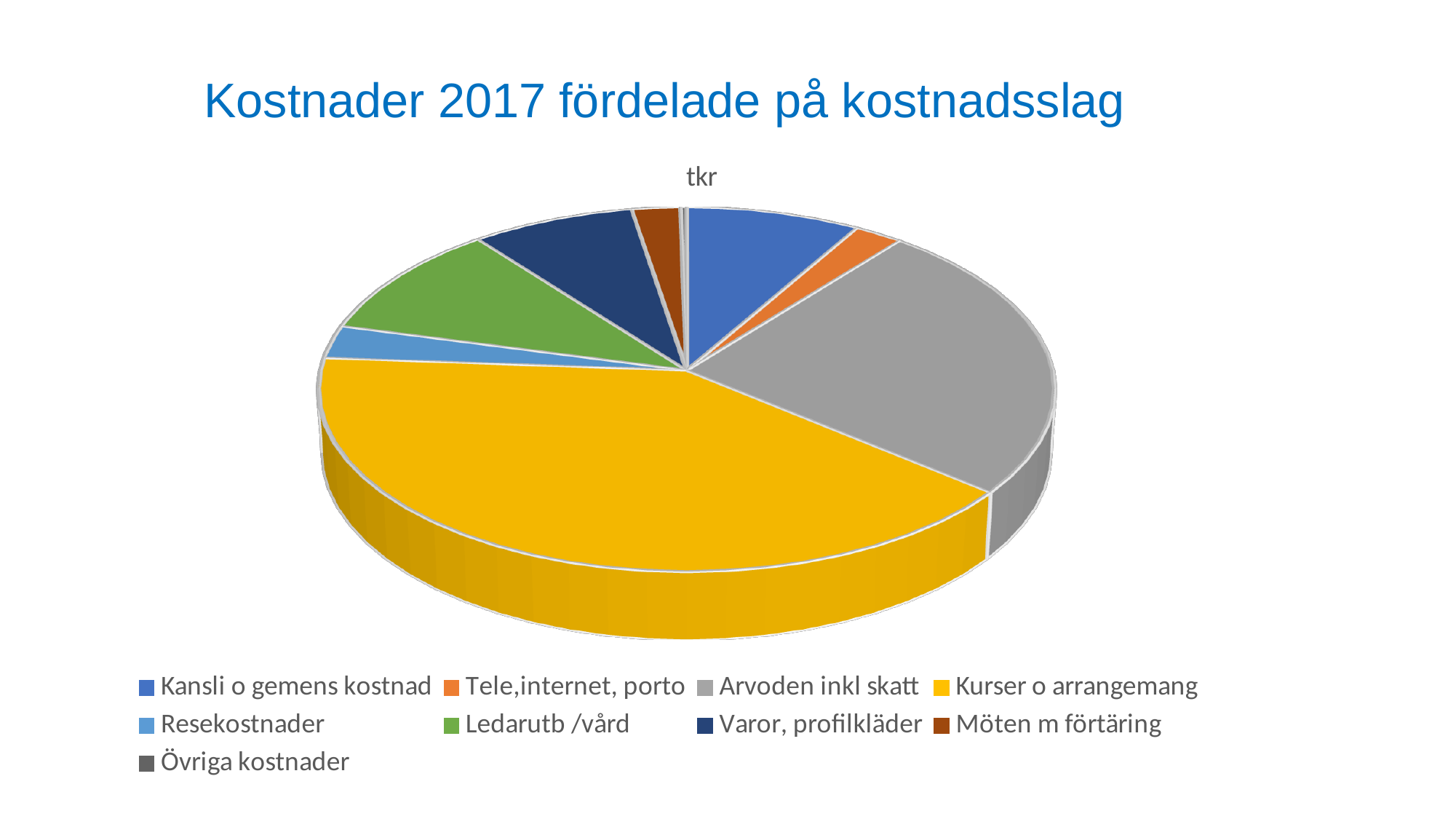
What kind of chart is shown on the slide? Pie chart Which category has the second largest slice of the pie? Arvoden inkl skatt Which category has the largest slice of the pie? Kurser o arrangemang What unit label is shown above the pie chart? tkr Which slice is larger, Arvoden inkl skatt or Kansli o gemens kostnad? Arvoden inkl skatt Which slice is larger, Kurser o arrangemang or Arvoden inkl skatt? Kurser o arrangemang Which category has the smallest slice of the pie? Övriga kostnader What is the title of the slide? Kostnader 2017 fördelade på kostnadsslag Which slice is larger, Ledarutb /vård or Resekostnader? Ledarutb /vård How many categories does the pie chart's legend list? 9